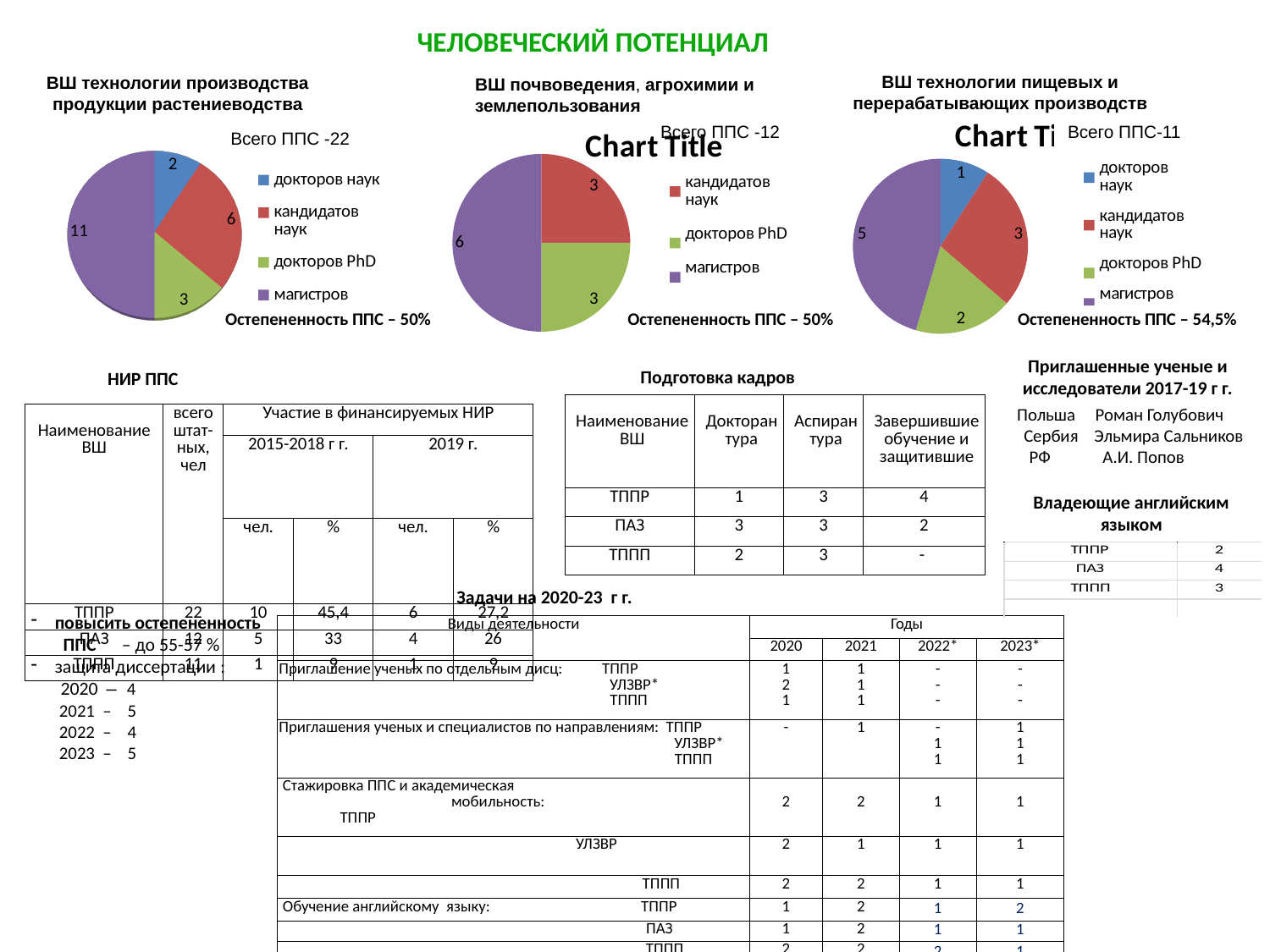
In the left pie chart (ВШ технологии производства продукции растениеводства), which category has the largest slice? магистров In the middle pie chart (ВШ почвоведения, агрохимии и землепользования), what is the value for магистров? 6 In the right pie chart (ВШ технологии пищевых и перерабатывающих производств), which is larger: магистров or докторов PhD? магистров In the left pie chart (ВШ технологии производства продукции растениеводства), what share of the pie does магистров represent? 50% In the middle pie chart (ВШ почвоведения, агрохимии и землепользования), how many categories does the legend list? 3 In the left pie chart (ВШ технологии производства продукции растениеводства), what is the value for магистров? 11 In the left pie chart (ВШ технологии производства продукции растениеводства), what is the value for докторов наук? 2 In the middle pie chart (ВШ почвоведения, агрохимии и землепользования), what share of the pie does кандидатов наук represent? 25% In the right pie chart (ВШ технологии пищевых и перерабатывающих производств), which category has the smallest slice? докторов наук What type of chart is used for the three charts at the top of the slide? pie chart In the right pie chart (ВШ технологии пищевых и перерабатывающих производств), what is the value for кандидатов наук? 3 In the left pie chart (ВШ технологии производства продукции растениеводства), what is the difference between кандидатов наук and докторов PhD? 3